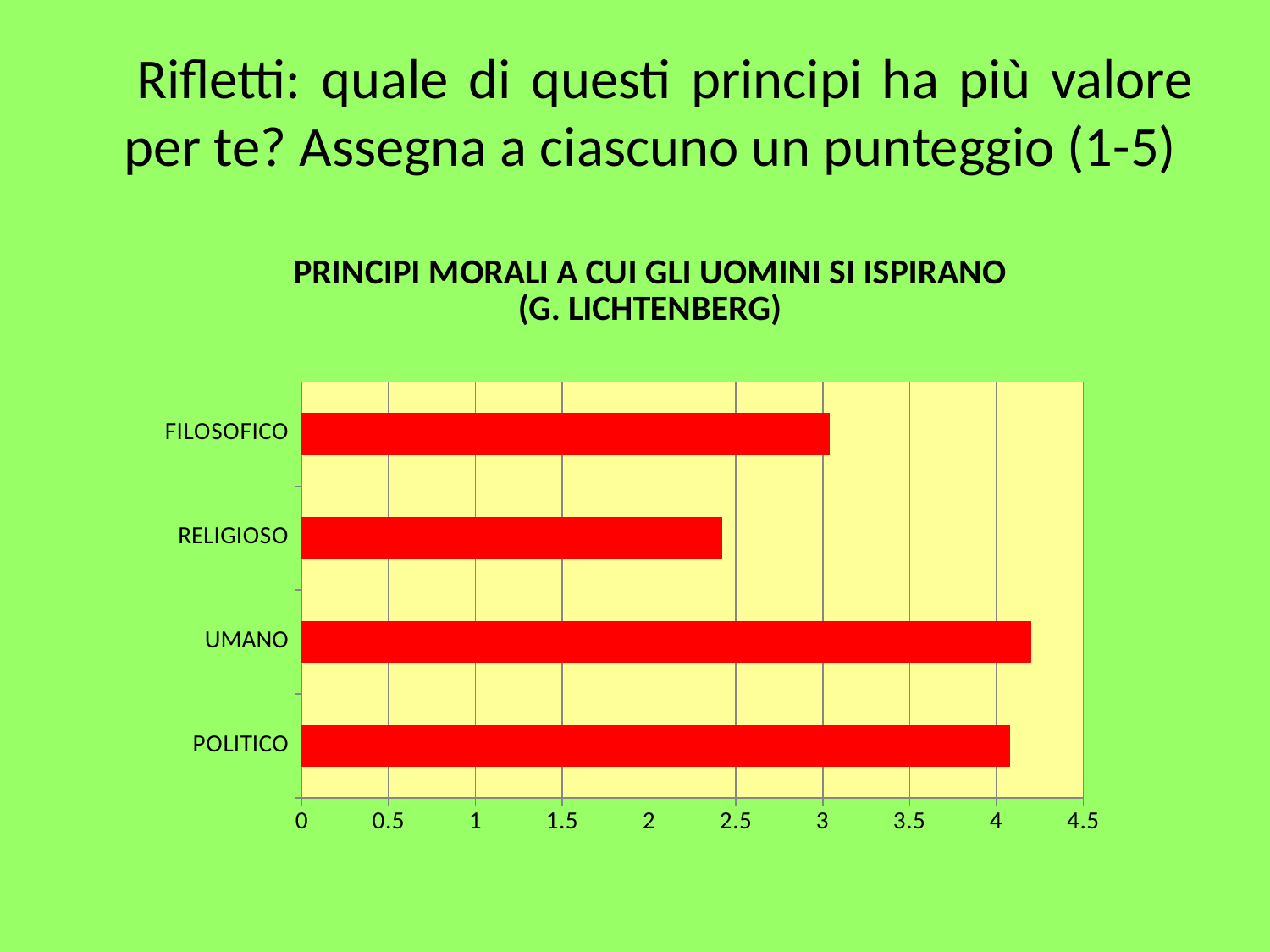
Which is larger, the value for POLITICO or the value for FILOSOFICO? POLITICO Is the value for RELIGIOSO greater or less than 3? less What is the title of the chart? PRINCIPI MORALI A CUI GLI UOMINI SI ISPIRANO (G. LICHTENBERG) Which is larger, the value for FILOSOFICO or the value for RELIGIOSO? FILOSOFICO Is the value for FILOSOFICO greater or less than 3.5? less What kind of chart is shown on the slide? bar chart Which category has the highest value in the chart? UMANO Is the value for UMANO greater or less than 4? greater Which category has the lowest value in the chart? RELIGIOSO How many categories are plotted in the chart? 4